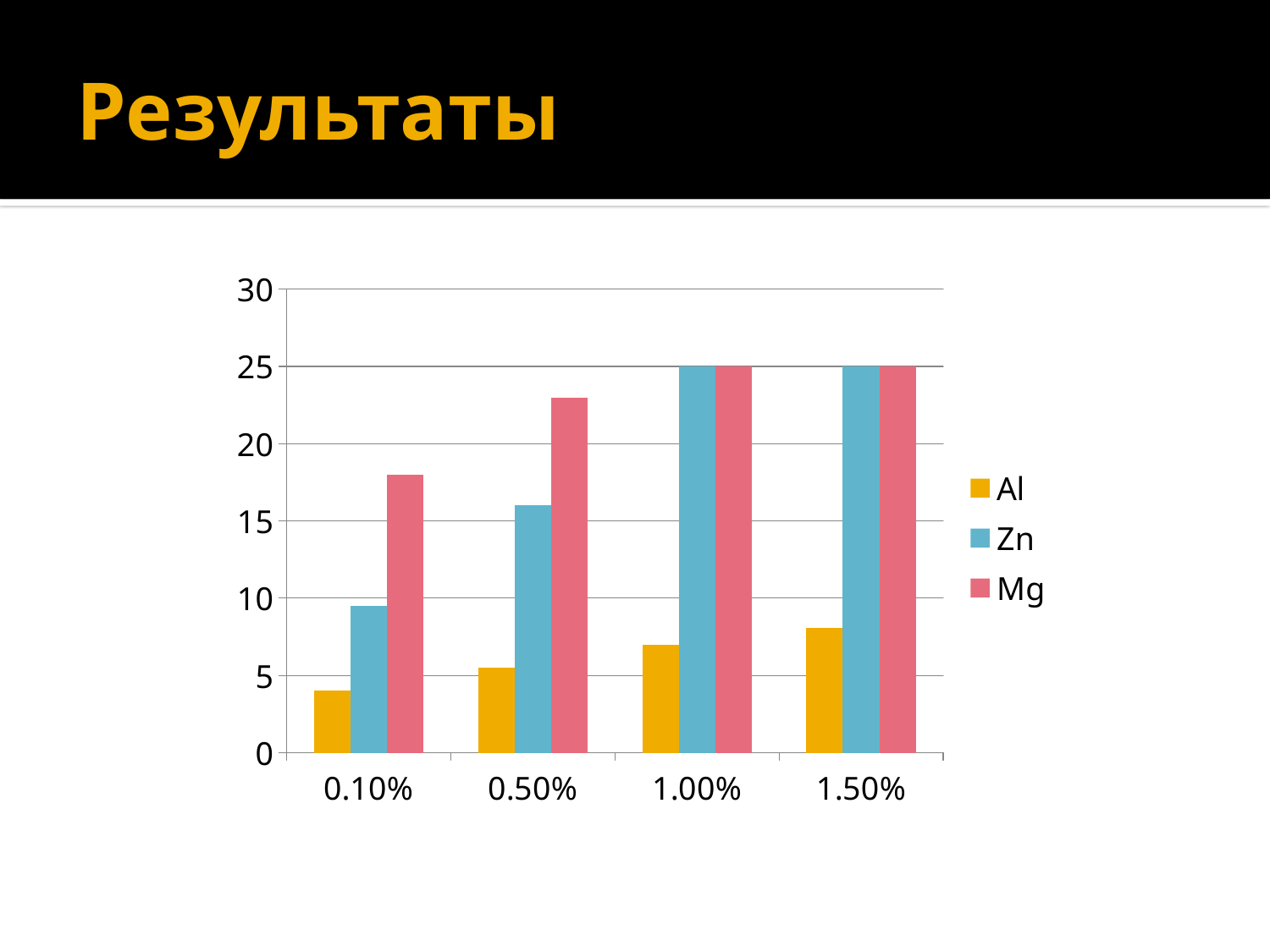
How many series does the legend list? 3 Is the value for Al at 0.10% greater or less than 5? less Which series has the lowest value at 1.50%? Al What is the value for Mg at 1.50%? 25 How many categories are shown on the x axis? 4 At 0.50%, which is larger, the value for Al or the value for Zn? Zn What kind of chart is shown on the slide? bar chart What is the value for Zn at 1.00%? 25 Do the values for Al rise or fall from 0.10% to 1.50%? rise Which series has the highest value at 0.10%? Mg Is the value for Mg at 0.50% greater or less than 20? greater Is the value for Mg at 0.10% greater or less than 15? greater